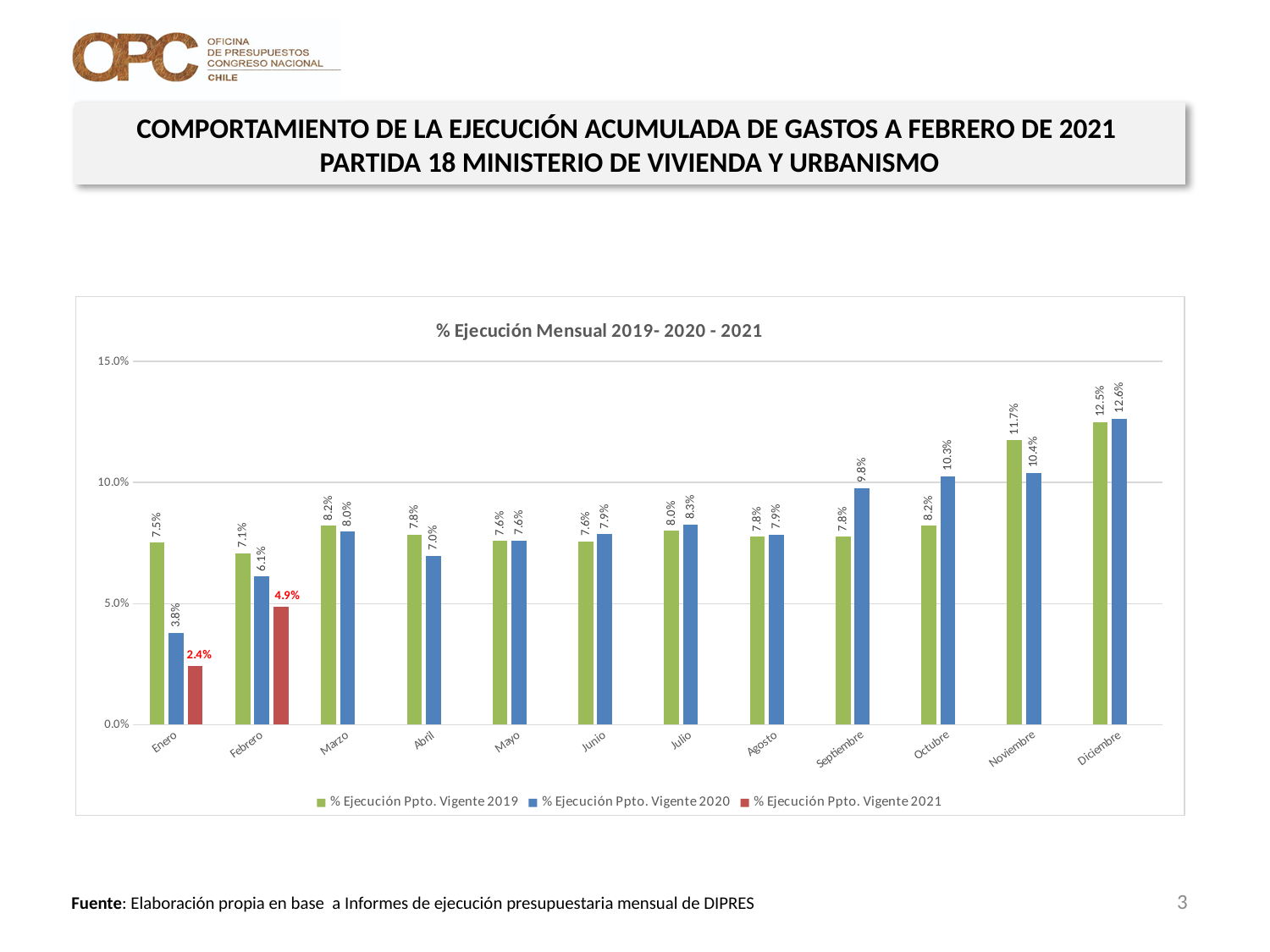
How many series does the legend list? 3 What is the difference between the 2019 and 2021 values in Febrero? 2.2% In which month is the % Ejecución Ppto. Vigente 2020 series lowest? Enero What is the value for % Ejecución Ppto. Vigente 2020 in Septiembre? 9.8% What is the value for % Ejecución Ppto. Vigente 2019 in Noviembre? 11.7% In which month is the % Ejecución Ppto. Vigente 2020 series highest? Diciembre What kind of chart is shown on the slide? Bar chart How many months are shown on the x axis? 12 What is the difference between the 2020 and 2019 values in Octubre? 2.1% What is the value for % Ejecución Ppto. Vigente 2021 in Enero? 2.4% What is the title of the chart? % Ejecución Mensual 2019- 2020 - 2021 Which is larger in Noviembre, the 2019 value or the 2020 value? 2019 value